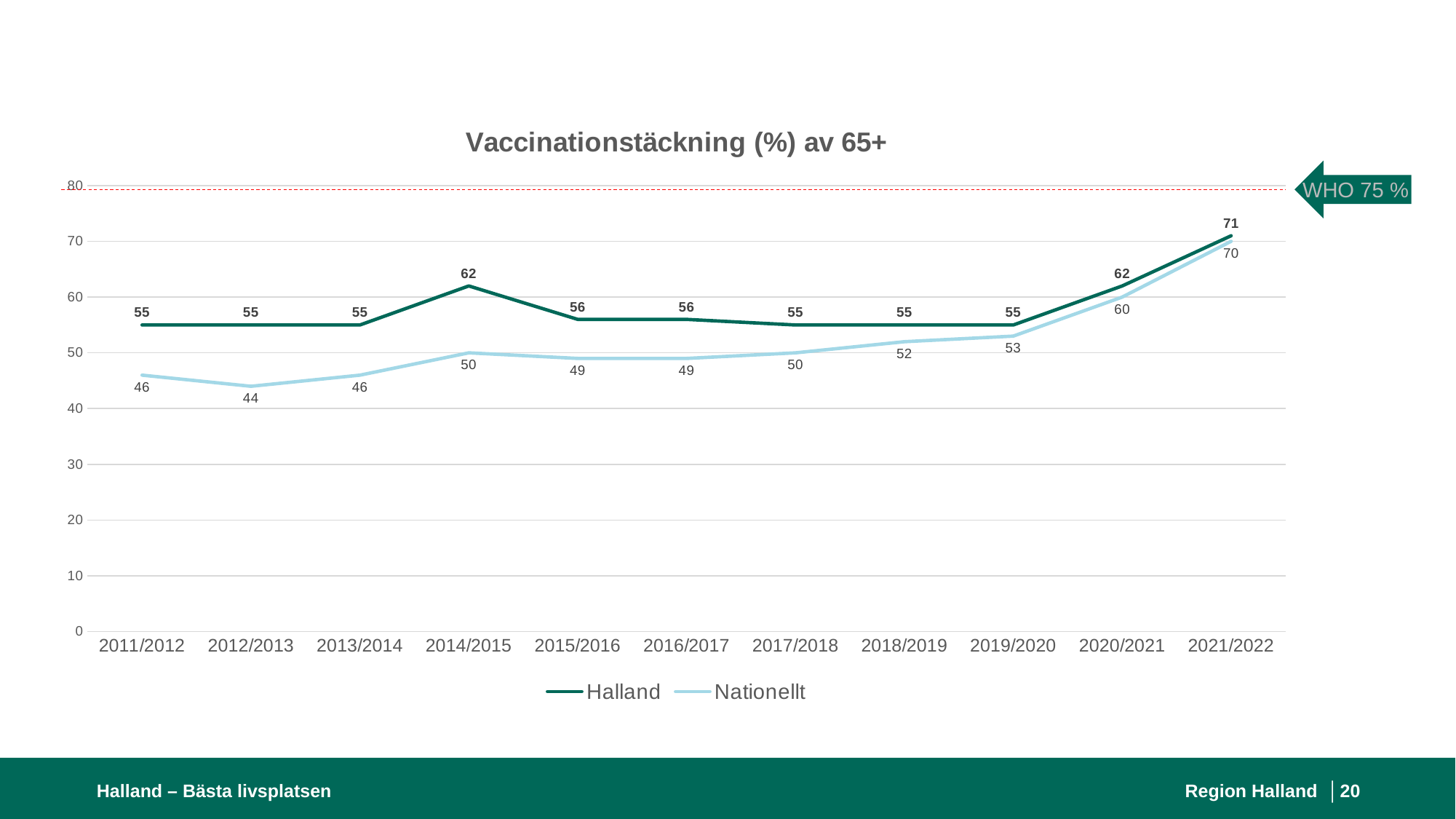
What is the Nationellt value for 2012/2013? 44 What is the title of the chart? Vaccinationstäckning (%) av 65+ Does the Nationellt series rise or fall from 2019/2020 to 2021/2022? Rise How many seasons are shown on the x axis? 11 In which season is the Nationellt value lowest? 2012/2013 What kind of chart is shown on the slide? Line chart How many series does the legend list? 2 What is the difference between the Halland and Nationellt values in 2011/2012? 9 In which season is the Halland value highest? 2021/2022 What is the Halland value for 2014/2015? 62 Which series has the larger value in 2020/2021, Halland or Nationellt? Halland What is the Nationellt value for 2021/2022? 70